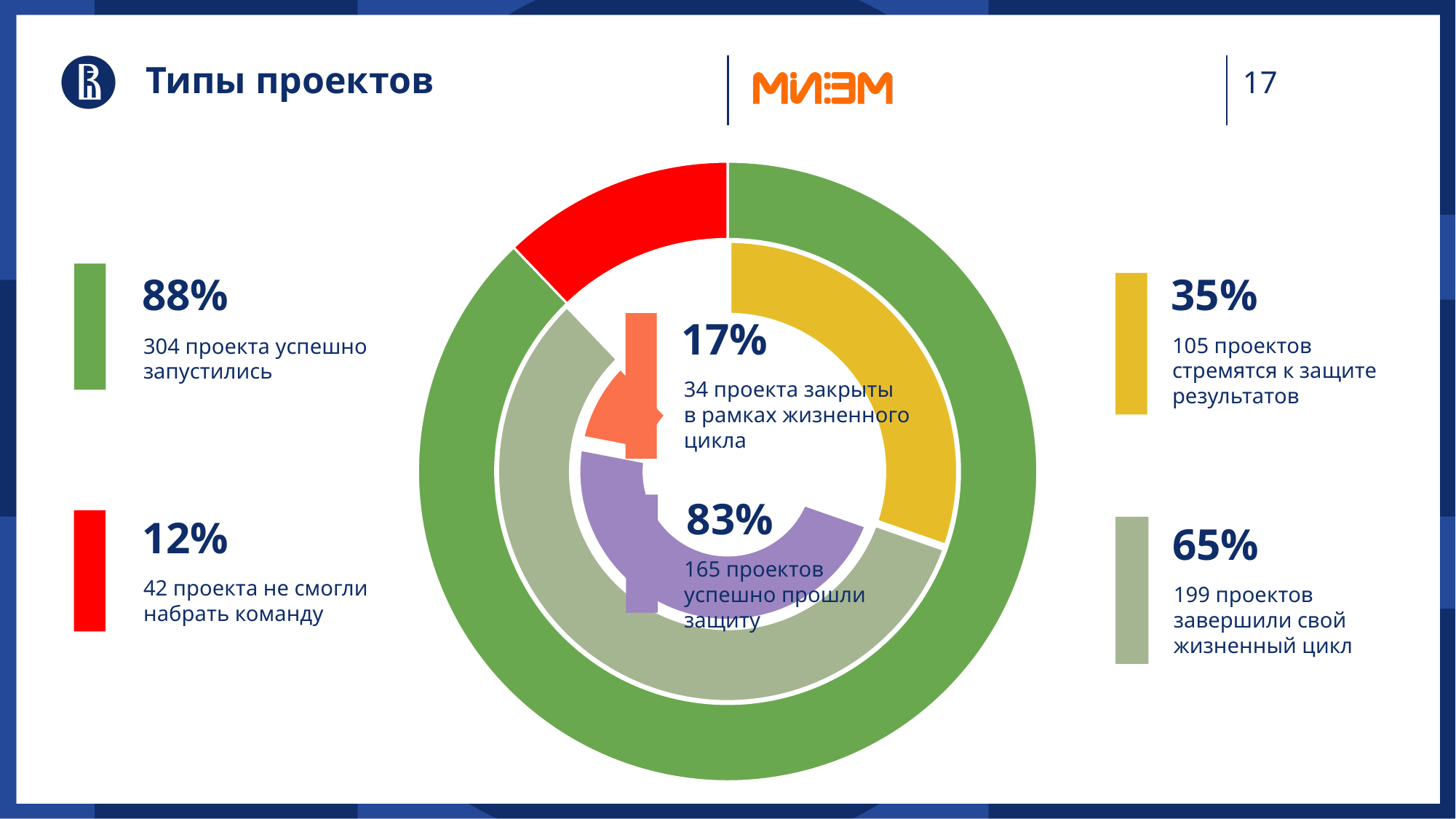
What kind of chart is shown on the slide? Donut (ring) chart How many projects could not assemble a team (не смогли набрать команду)? 42 What is the difference between the number of projects that successfully passed the defense and the number closed within the life cycle? 131 What percentage of projects successfully launched (успешно запустились)? 88% What is the title of the chart slide? Типы проектов How many projects completed their life cycle (завершили свой жизненный цикл)? 199 Which is larger: the number of projects that completed their life cycle or the number aiming to defend results? Projects that completed their life cycle (199) What percentage of projects were closed within the life cycle (закрыты в рамках жизненного цикла)? 17% What is the difference between the number of projects that successfully launched and the number that could not assemble a team? 262 How many projects successfully passed the defense (успешно прошли защиту)? 165 What colour represents the projects that could not assemble a team? Red What percentage of projects aim to defend their results (стремятся к защите результатов)? 35%